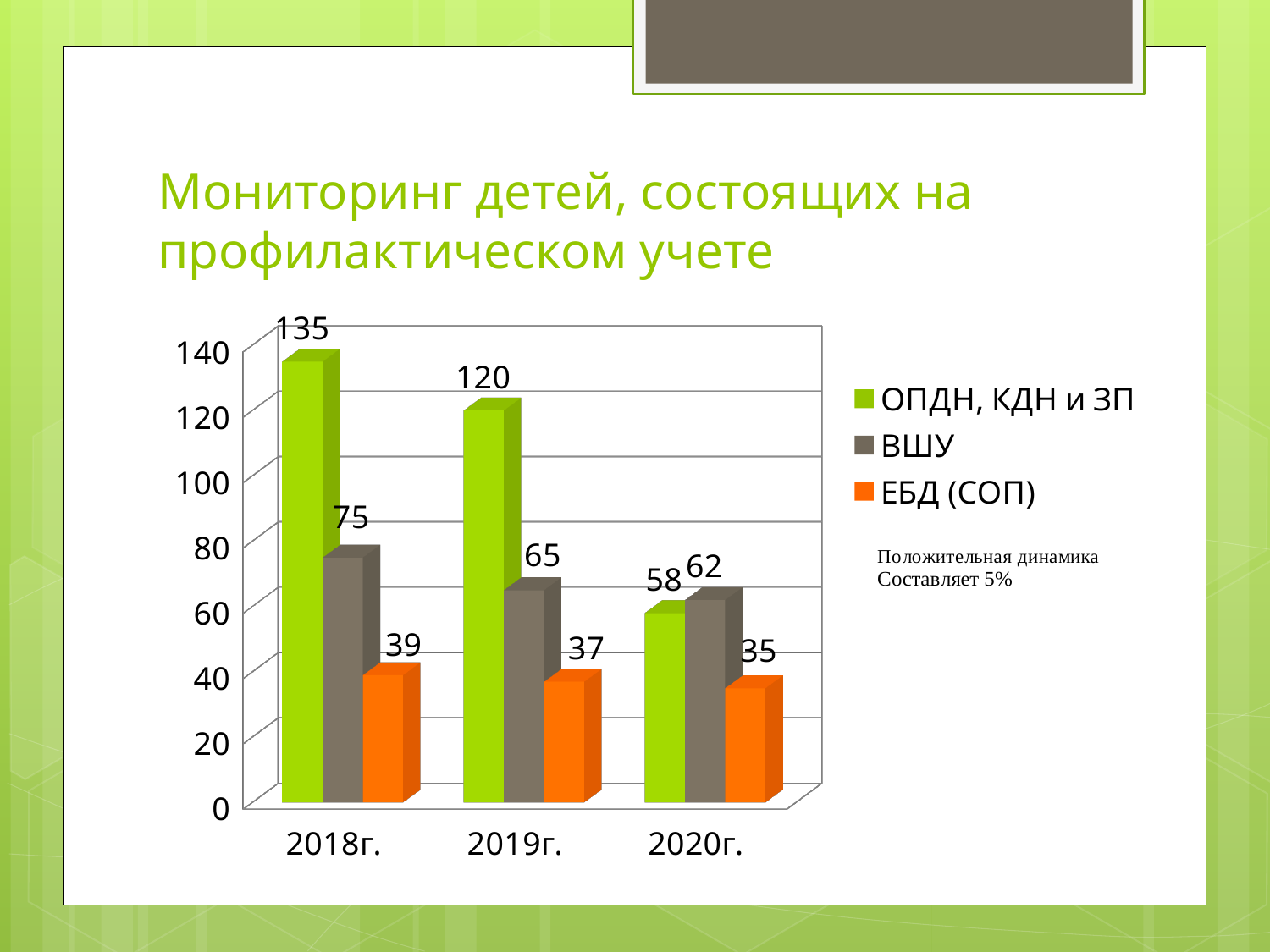
What colour are the bars for ЕБД (СОП)? orange Do the values for ОПДН, КДН и ЗП rise or fall from 2018г. to 2020г.? fall How many years are shown on the x axis? 3 Which year has the lowest value for ЕБД (СОП)? 2020г. What kind of chart is shown on the slide? bar chart Which year has the highest value for ОПДН, КДН и ЗП? 2018г. How many series does the legend list? 3 What is the value for ВШУ in 2019г.? 65 What is the difference between the ОПДН, КДН и ЗП values for 2018г. and 2019г.? 15 In 2020г., which is larger: ОПДН, КДН и ЗП or ВШУ? ВШУ What is the value for ЕБД (СОП) in 2020г.? 35 What is the value for ОПДН, КДН и ЗП in 2018г.? 135